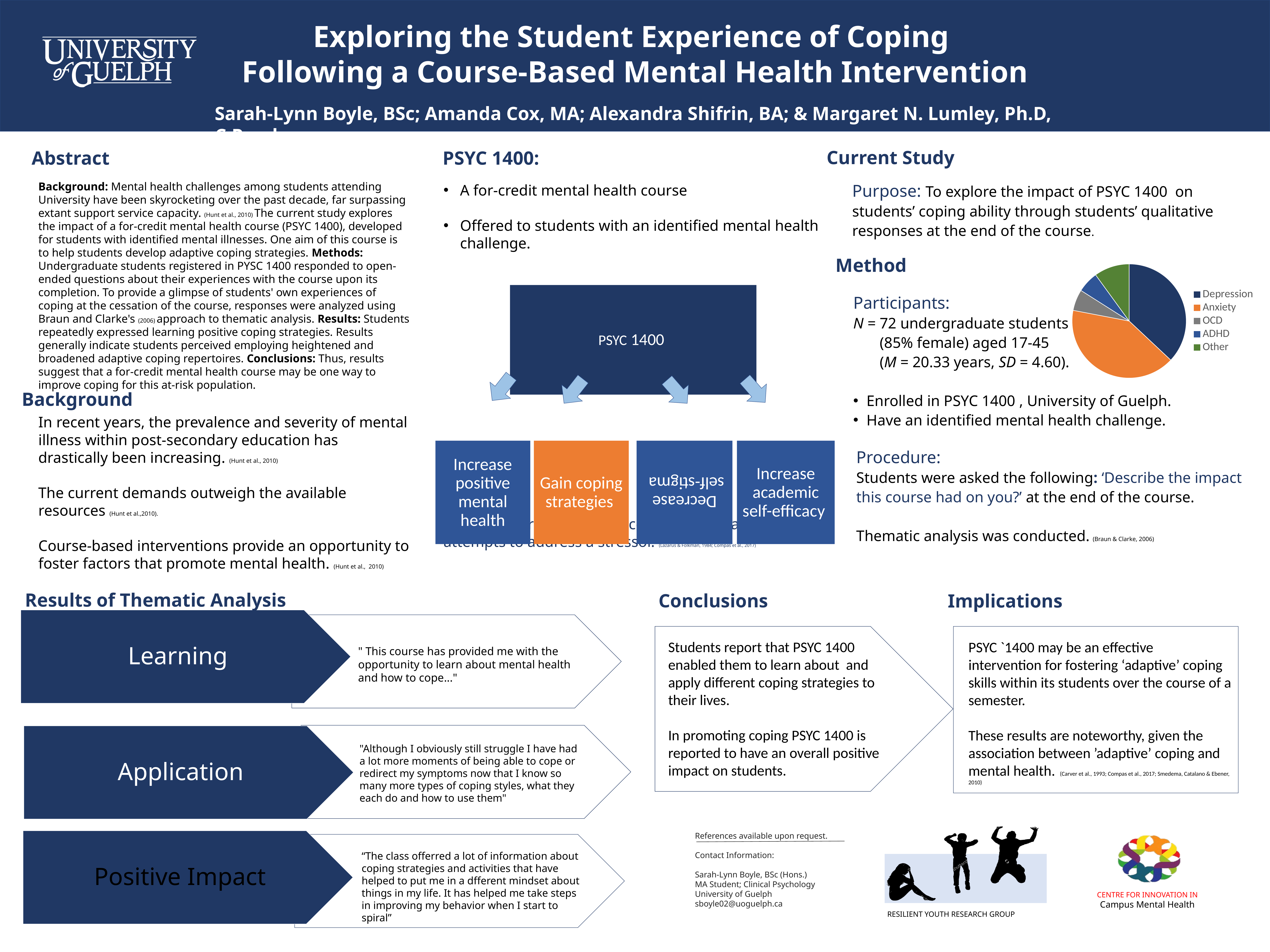
How many categories does the pie chart in the Method section show? 5 What colour represents Anxiety in the pie chart? orange In the pie chart, which slice is larger: Other or OCD? Other Which category is shown in green in the pie chart? Other What kind of chart is shown in the Method section of the slide? pie chart How many entries does the legend of the pie chart list? 5 In the pie chart, which slice is larger: Anxiety or ADHD? Anxiety In the pie chart, which slice is larger: Depression or ADHD? Depression